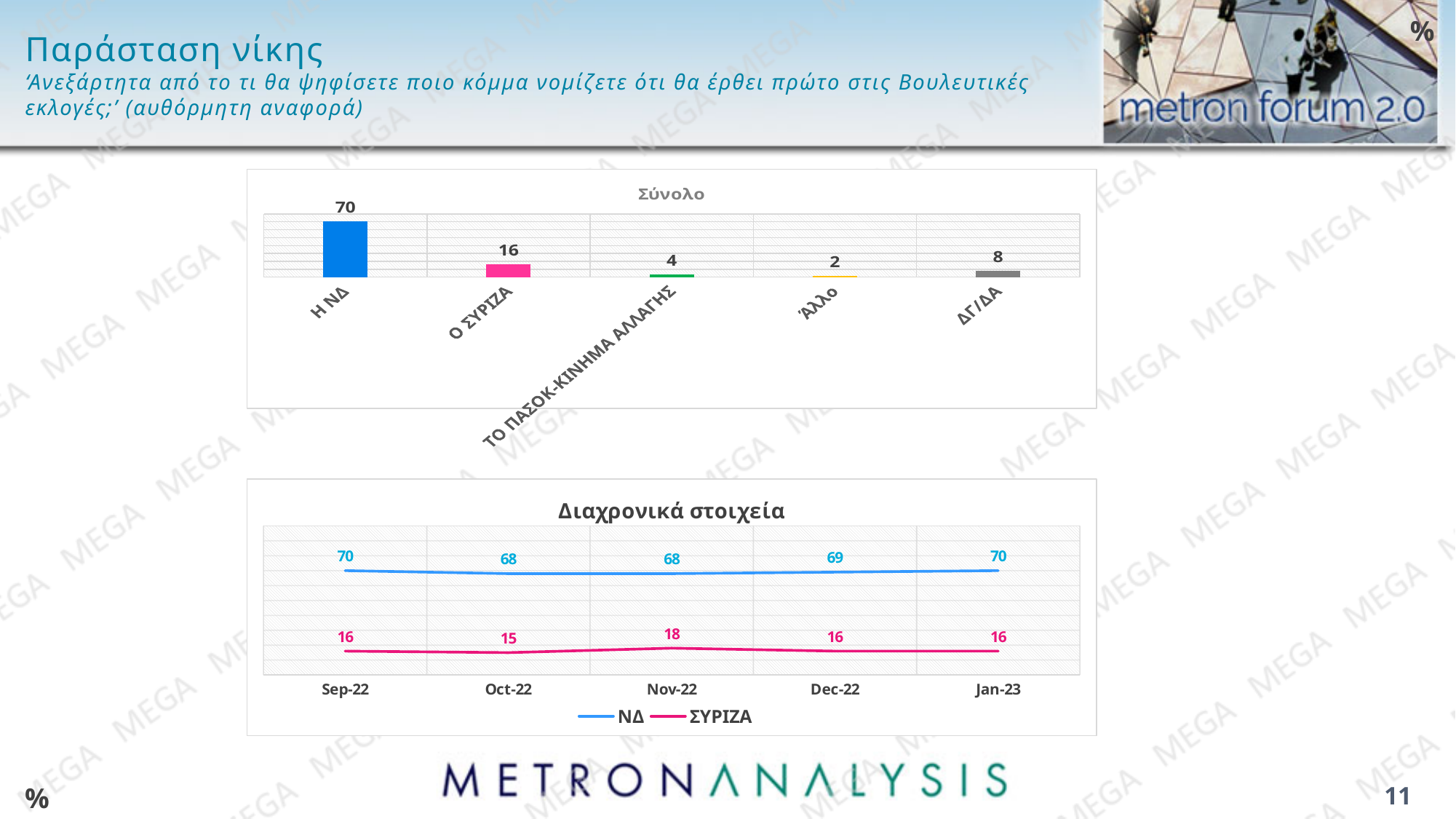
In the 'Διαχρονικά στοιχεία' chart, how many series does the legend list? 2 In the 'Σύνολο' chart, which category has the lowest value? Άλλο In the 'Σύνολο' chart, what is the value for ΔΓ/ΔΑ? 8 In the 'Σύνολο' chart, what is the difference between the values for Η ΝΔ and Ο ΣΥΡΙΖΑ? 54 In the 'Διαχρονικά στοιχεία' chart, in which month does ΣΥΡΙΖΑ have its lowest value? Oct-22 In the 'Σύνολο' chart, how many categories are shown? 5 What kind of chart is the 'Σύνολο' chart? bar chart In the 'Σύνολο' chart, what is the value for Η ΝΔ? 70 In the 'Διαχρονικά στοιχεία' chart, what is the value for ΝΔ in Dec-22? 69 What kind of chart is the 'Διαχρονικά στοιχεία' chart? line chart In the 'Διαχρονικά στοιχεία' chart, what is the difference between ΝΔ and ΣΥΡΙΖΑ in Jan-23? 54 In the 'Διαχρονικά στοιχεία' chart, what is the value for ΣΥΡΙΖΑ in Nov-22? 18